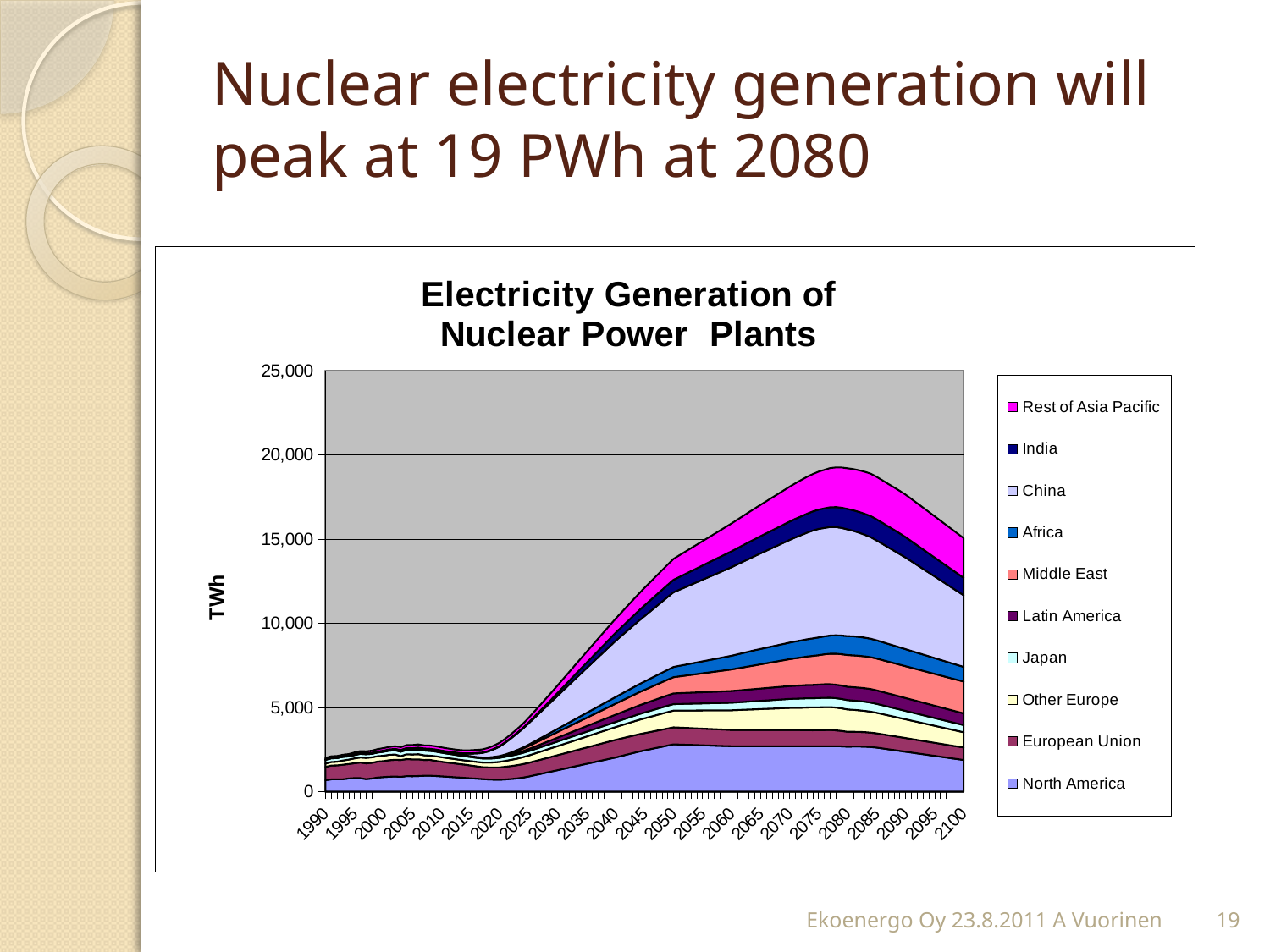
Is the total nuclear electricity generation in 1990 greater or less than 5,000 TWh? less What is the title of the chart? Electricity Generation of Nuclear Power Plants Is the total nuclear electricity generation in 2080 greater or less than 15,000 TWh? greater What is the label on the vertical axis? TWh Is the total nuclear electricity generation in 2080 greater or less than 20,000 TWh? less What kind of chart is shown on the slide? Stacked area chart In which year does total nuclear electricity generation reach its peak? 2080 How many series does the legend list? 10 Which region contributes the largest share of nuclear electricity generation in 2080? China Does total nuclear electricity generation rise or fall between 2080 and 2100? fall Does total nuclear electricity generation rise or fall between 2020 and 2080? rise